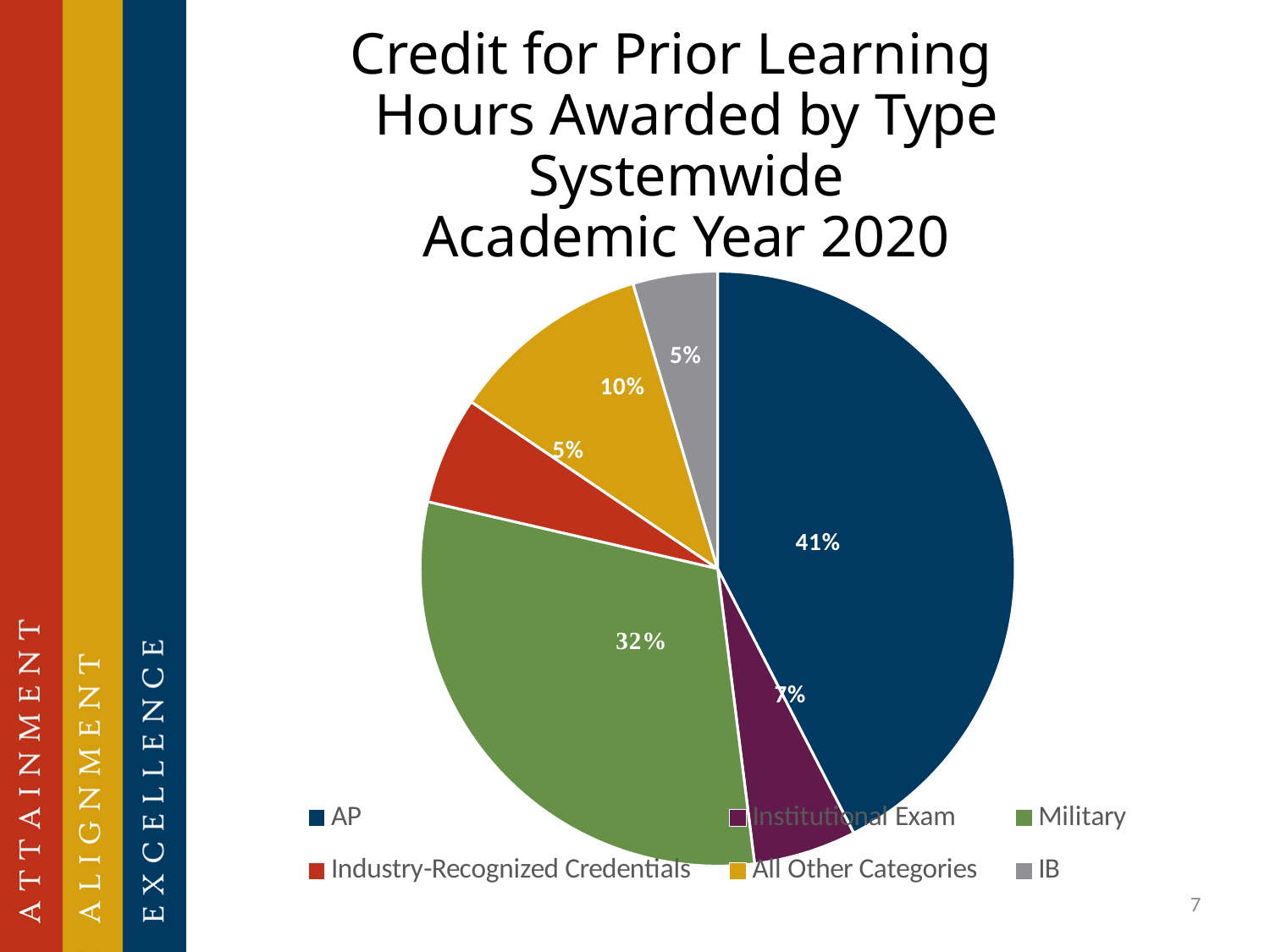
What is the difference in percentage points between the All Other Categories share and the IB share? 5 percentage points What kind of chart is shown on the slide? Pie chart What is the difference in percentage points between the AP share and the Military share? 9 percentage points What share of hours was awarded for Institutional Exam? 7% How many categories does the pie chart show? 6 What share of hours was awarded for Military? 32% What colour is the slice for Military? Green What share of hours was awarded for Industry-Recognized Credentials? 5% What share of hours was awarded for All Other Categories? 10% Which is larger, the share for Military or the share for All Other Categories? Military What share of Credit for Prior Learning hours was awarded for AP? 41% Which type accounts for the largest share of hours awarded? AP